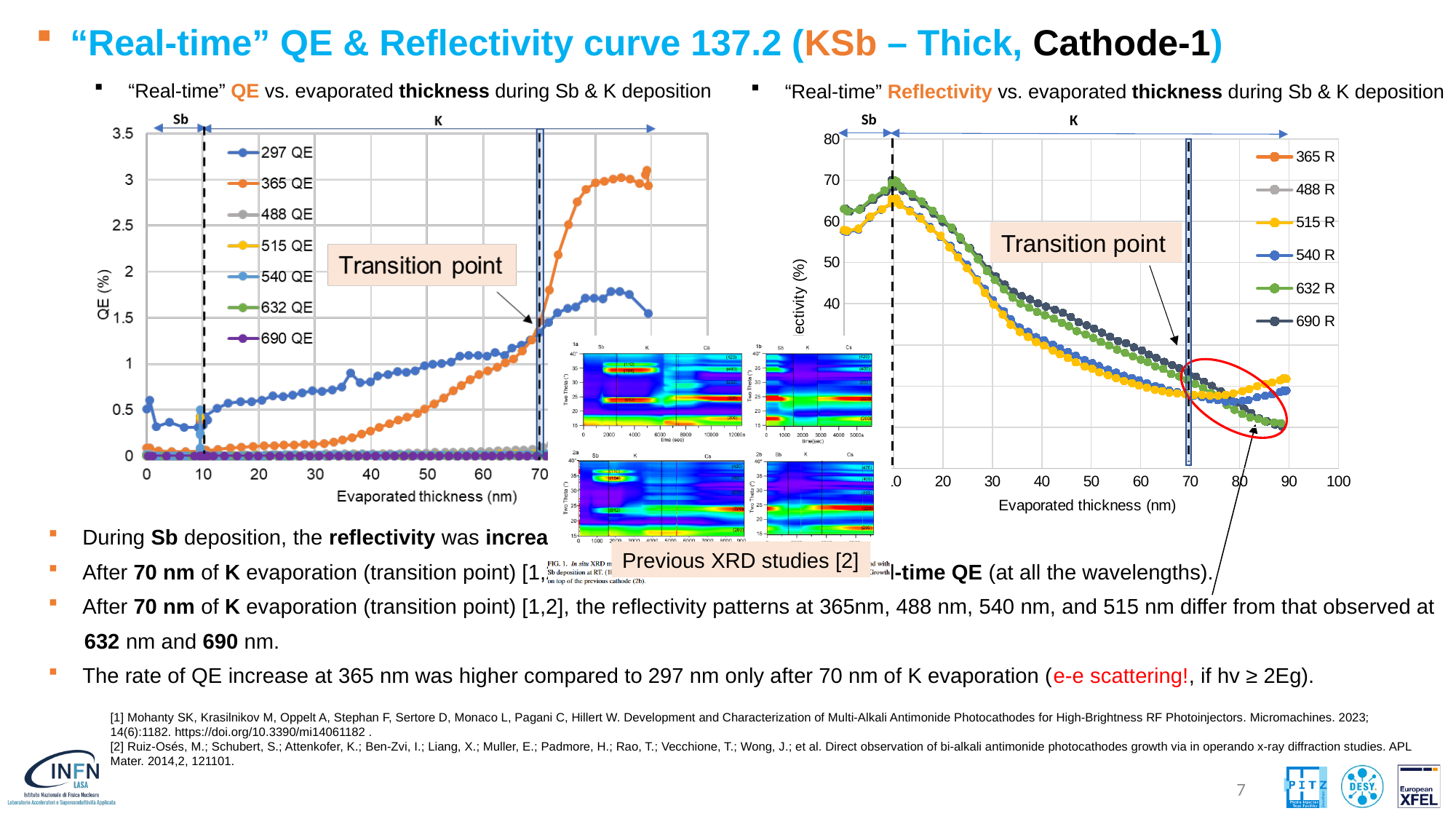
In the right Reflectivity chart, at 50 nm evaporated thickness, which series has the higher reflectivity: 515 R or 690 R? 690 R In the left QE chart, is the peak value of the 365 QE series greater or less than 2.5? greater In the left QE chart, is the value of the 365 QE series at 50 nm greater or less than 1? less In the left QE chart, at 50 nm evaporated thickness, which series has the higher QE: 297 QE or 365 QE? 297 QE What kind of chart is the left chart, "Real-time" QE vs. evaporated thickness? line chart In the right Reflectivity chart, which series has the lowest reflectivity at 50 nm evaporated thickness? 515 R How many series does the legend of the left QE chart list? 7 How many series does the legend of the right Reflectivity chart list? 6 In the right Reflectivity chart, is the peak value of the 632 R series greater or less than 60? greater What is the x-axis label of the left QE chart? Evaporated thickness (nm) In the right Reflectivity chart, do the reflectivity values rise or fall along the x axis during the K deposition (after about 10 nm)? fall In the left QE chart, which series reaches the highest QE value? 365 QE